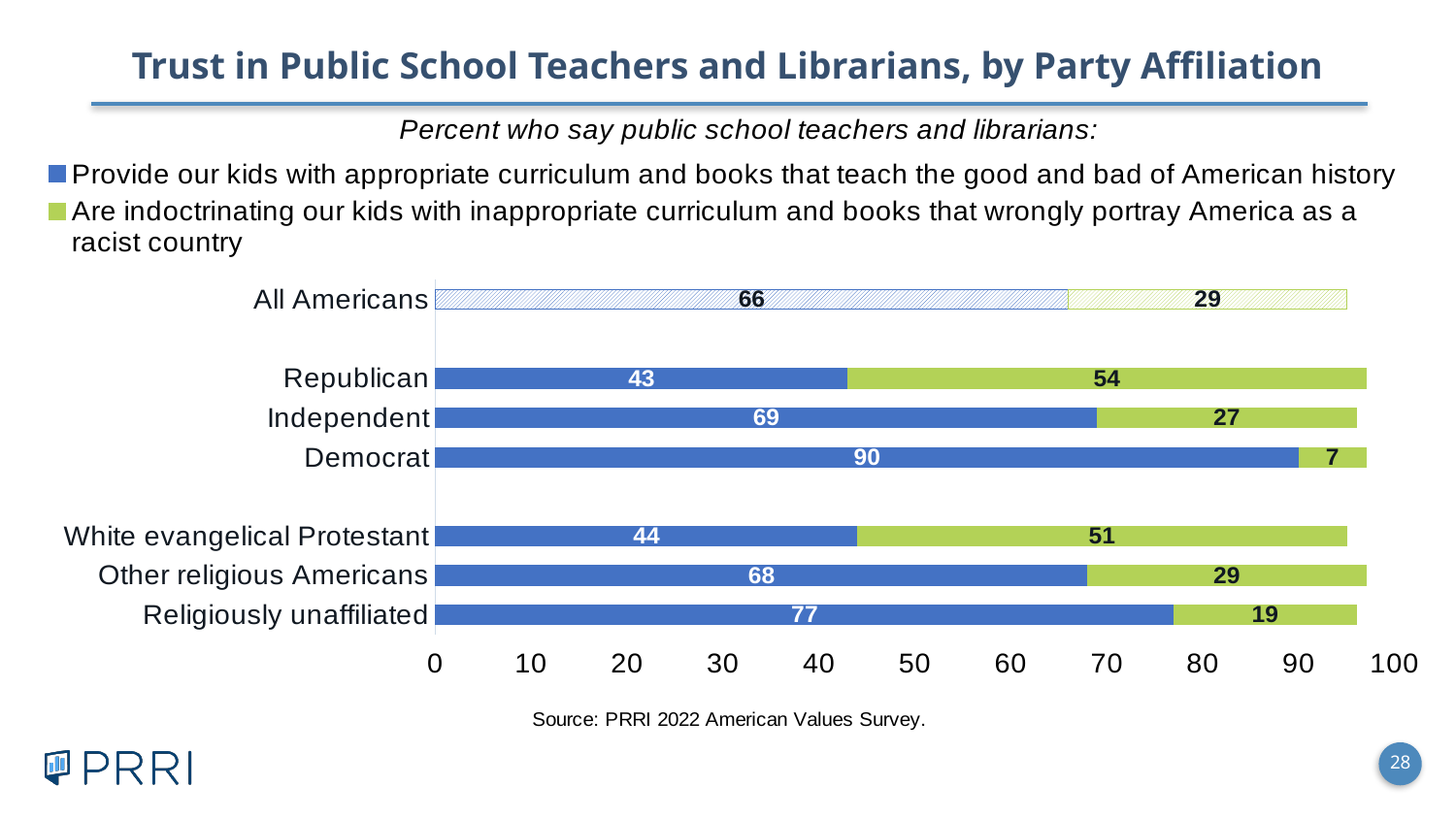
What is the difference between the Independent and Republican values for 'Provide our kids with appropriate curriculum and books'? 26 How many categories are shown on the chart? 7 What is the total of the stacked bar for Republican? 97 How many series does the legend list? 2 What kind of chart is shown on the slide? Stacked bar chart Which category has the lowest value for 'Are indoctrinating our kids with inappropriate curriculum and books'? Democrat What is the value for All Americans in the 'Provide our kids with appropriate curriculum' series? 66 What percentage of Republicans say public school teachers and librarians are indoctrinating our kids with inappropriate curriculum and books? 54 What is the source cited below the chart? PRRI 2022 American Values Survey Which category has the highest value for 'Provide our kids with appropriate curriculum and books'? Democrat Which is larger: the 'indoctrinating' value for White evangelical Protestant or for Religiously unaffiliated? White evangelical Protestant What percentage of Democrats say public school teachers and librarians provide our kids with appropriate curriculum and books? 90